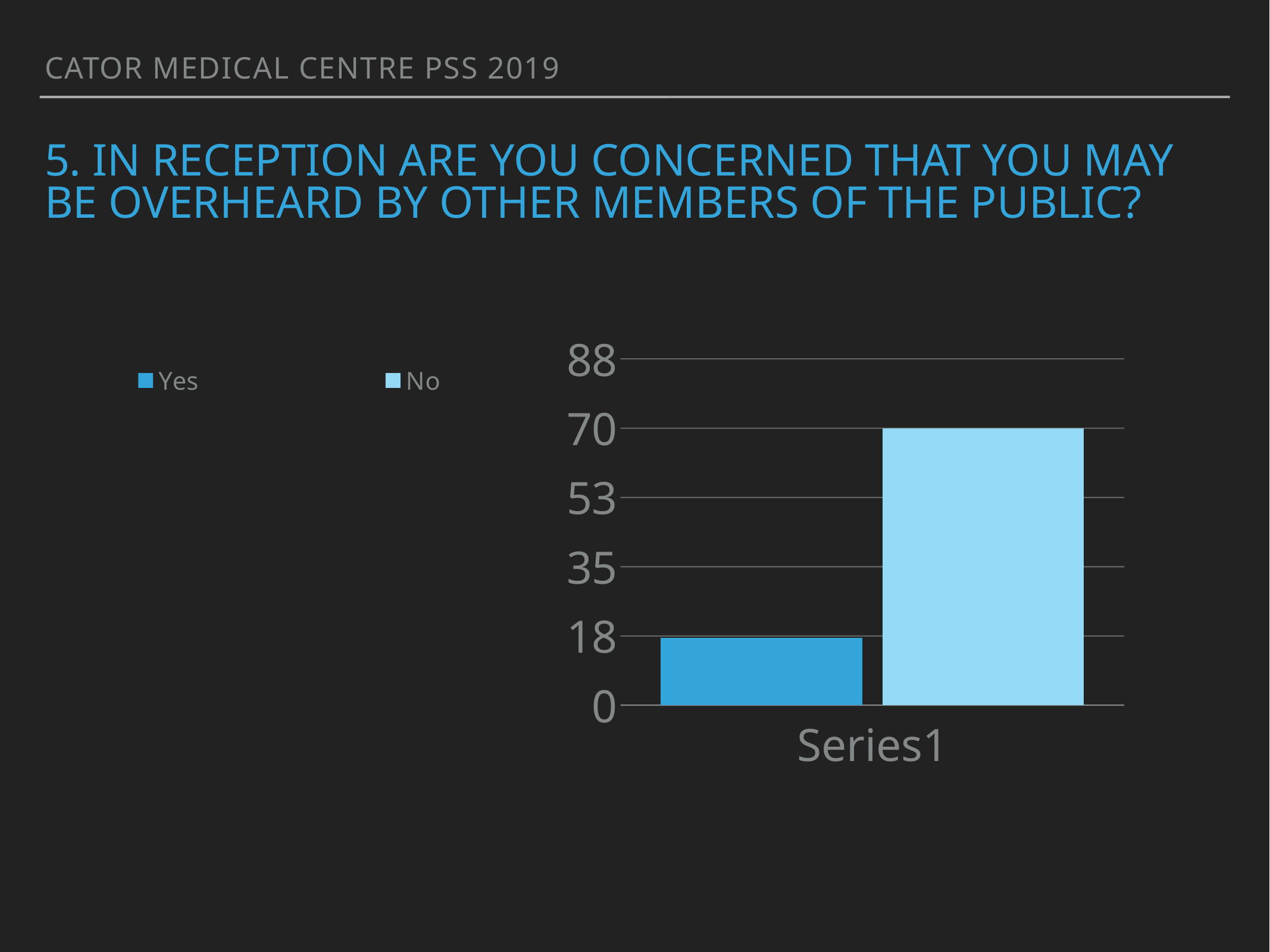
Which series has the highest value? No What type of chart is shown on the slide? bar chart What is the value of the No bar? 70 How many series does the legend list? 2 Is the value for No greater or less than 53? greater Which response has the higher bar, Yes or No? No Which series has the lowest value? Yes What is the category label shown on the x axis? Series1 Is the value for Yes greater or less than 35? less What is the highest value shown on the vertical axis? 88